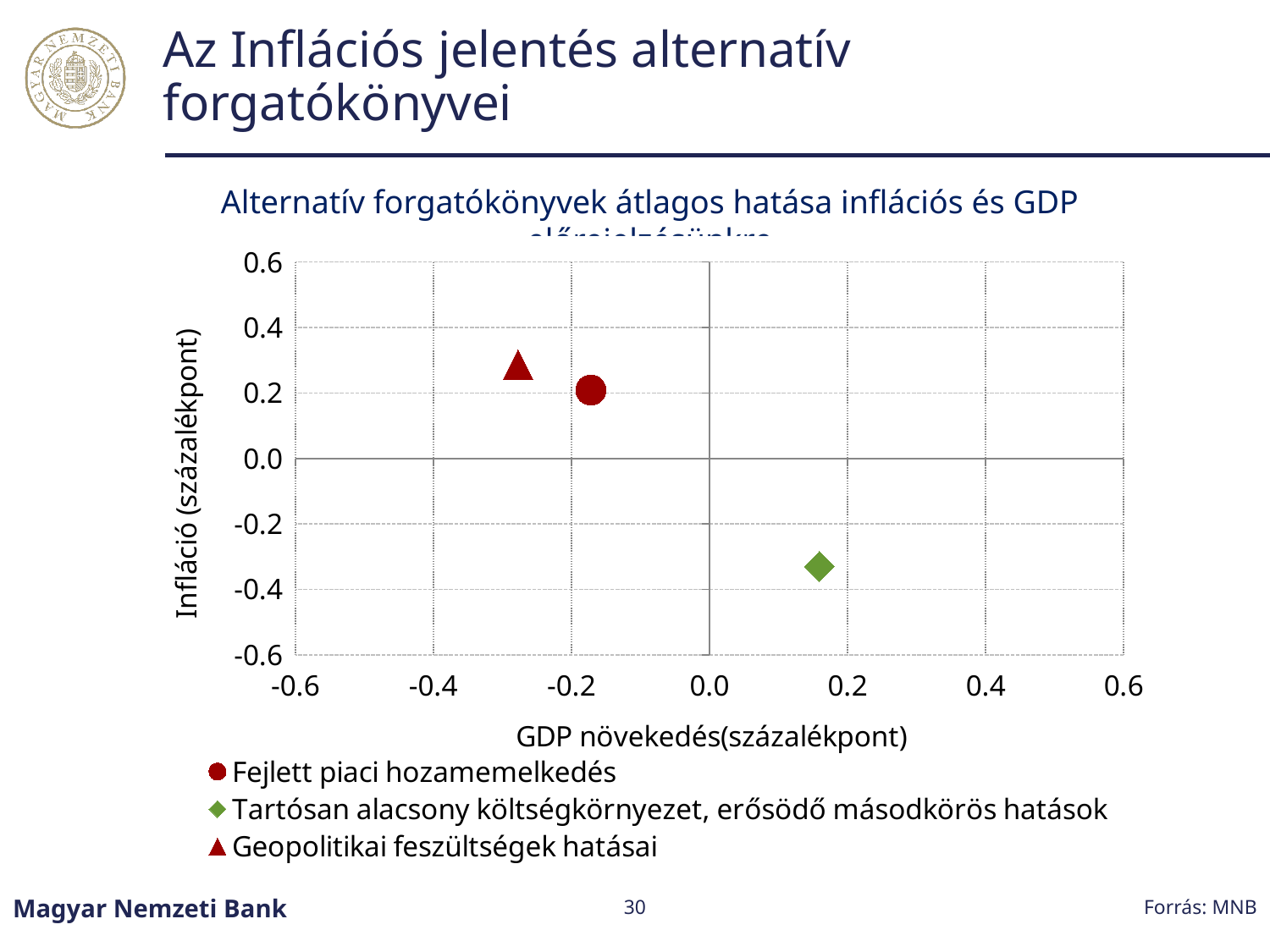
Which has the higher inflation effect, Geopolitikai feszültségek hatásai or Fejlett piaci hozamemelkedés? Geopolitikai feszültségek hatásai Is the inflation value for Tartósan alacsony költségkörnyezet, erősödő másodkörös hatások greater or less than -0.2? less Which scenario has the lowest inflation effect? Tartósan alacsony költségkörnyezet, erősödő másodkörös hatások Is the inflation value for Fejlett piaci hozamemelkedés greater or less than 0.0? greater Which scenario has the highest GDP growth effect? Tartósan alacsony költségkörnyezet, erősödő másodkörös hatások How many series does the legend list? 3 What is the label of the horizontal axis? GDP növekedés(százalékpont) Is the GDP growth value for Geopolitikai feszültségek hatásai greater or less than -0.2? less How many data points are plotted on the chart? 3 What kind of chart is shown on the slide? scatter chart